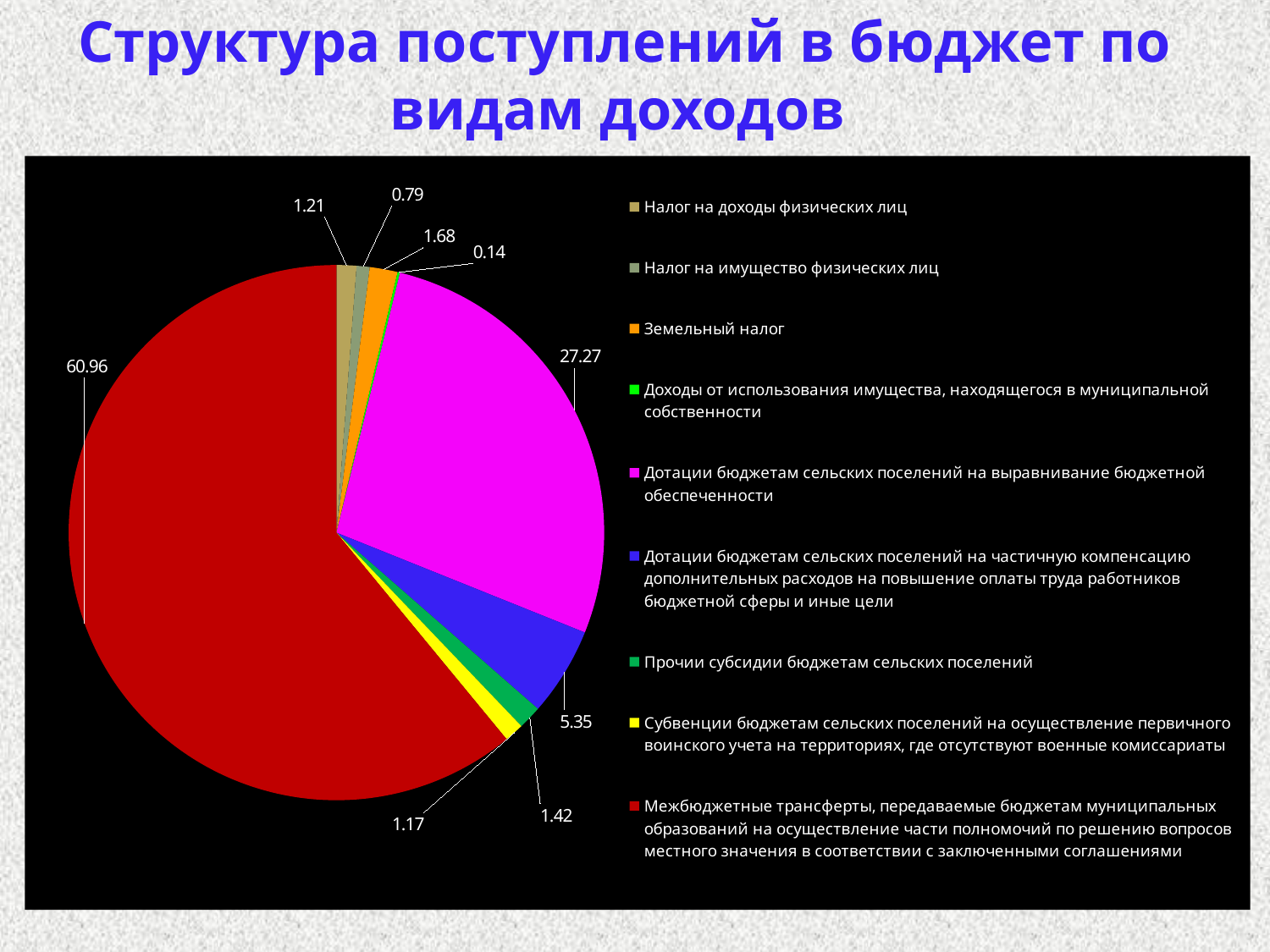
What is the value shown for "Прочии субсидии бюджетам сельских поселений"? 1.42 What is the difference between the values for "Межбюджетные трансферты..." (60.96) and "Дотации ... на выравнивание бюджетной обеспеченности" (27.27)? 33.69 Which is larger: the value for "Земельный налог" or the value for "Налог на имущество физических лиц"? Земельный налог Which category has the largest slice of the pie? Межбюджетные трансферты, передаваемые бюджетам муниципальных образований на осуществление части полномочий по решению вопросов местного значения в соответствии с заключенными соглашениями How many categories does the legend list? 9 What colour is the slice for "Дотации бюджетам сельских поселений на частичную компенсацию дополнительных расходов..."? blue Which category has the smallest slice of the pie? Доходы от использования имущества, находящегося в муниципальной собственности What type of chart is shown on the slide? pie chart What is the value shown for "Земельный налог"? 1.68 What is the value shown for the slice "Межбюджетные трансферты, передаваемые бюджетам муниципальных образований..."? 60.96 What is the value shown for "Дотации бюджетам сельских поселений на выравнивание бюджетной обеспеченности"? 27.27 What is the value shown for "Налог на доходы физических лиц"? 1.21